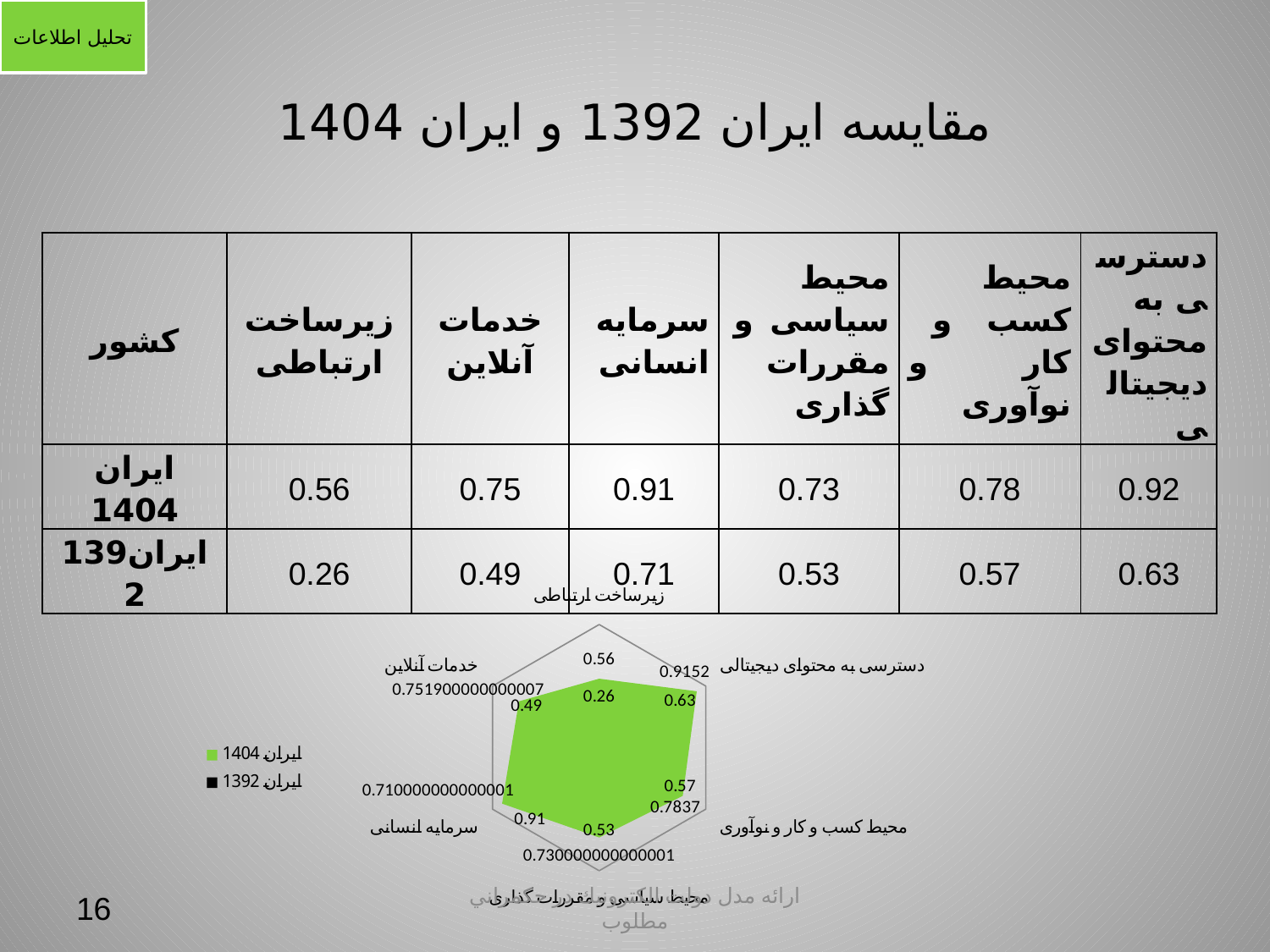
How many series does the chart legend list? 2 On which axis does the ایران 1404 series have its highest value? دسترسی به محتوای دیجیتالی What is the value for ایران 1404 on the دسترسی به محتوای دیجیتالی axis? 0.9152 What is the value for ایران 1404 on the زیرساخت ارتباطی axis? 0.56 What kind of chart is shown on the slide? radar chart On which axis does the ایران 1392 series have its lowest value? زیرساخت ارتباطی Which series has the larger value on the محیط سیاسی و مقررات گذاری axis, ایران 1404 or ایران 1392? ایران 1404 What are the two series named in the chart legend? ایران 1404 and ایران 1392 What is the value for ایران 1392 on the زیرساخت ارتباطی axis? 0.26 How many categories (axes) does the radar chart have? 6 What is the difference between the ایران 1404 and ایران 1392 values on the زیرساخت ارتباطی axis? 0.30 What is the value for ایران 1392 on the محیط کسب و کار و نوآوری axis? 0.57